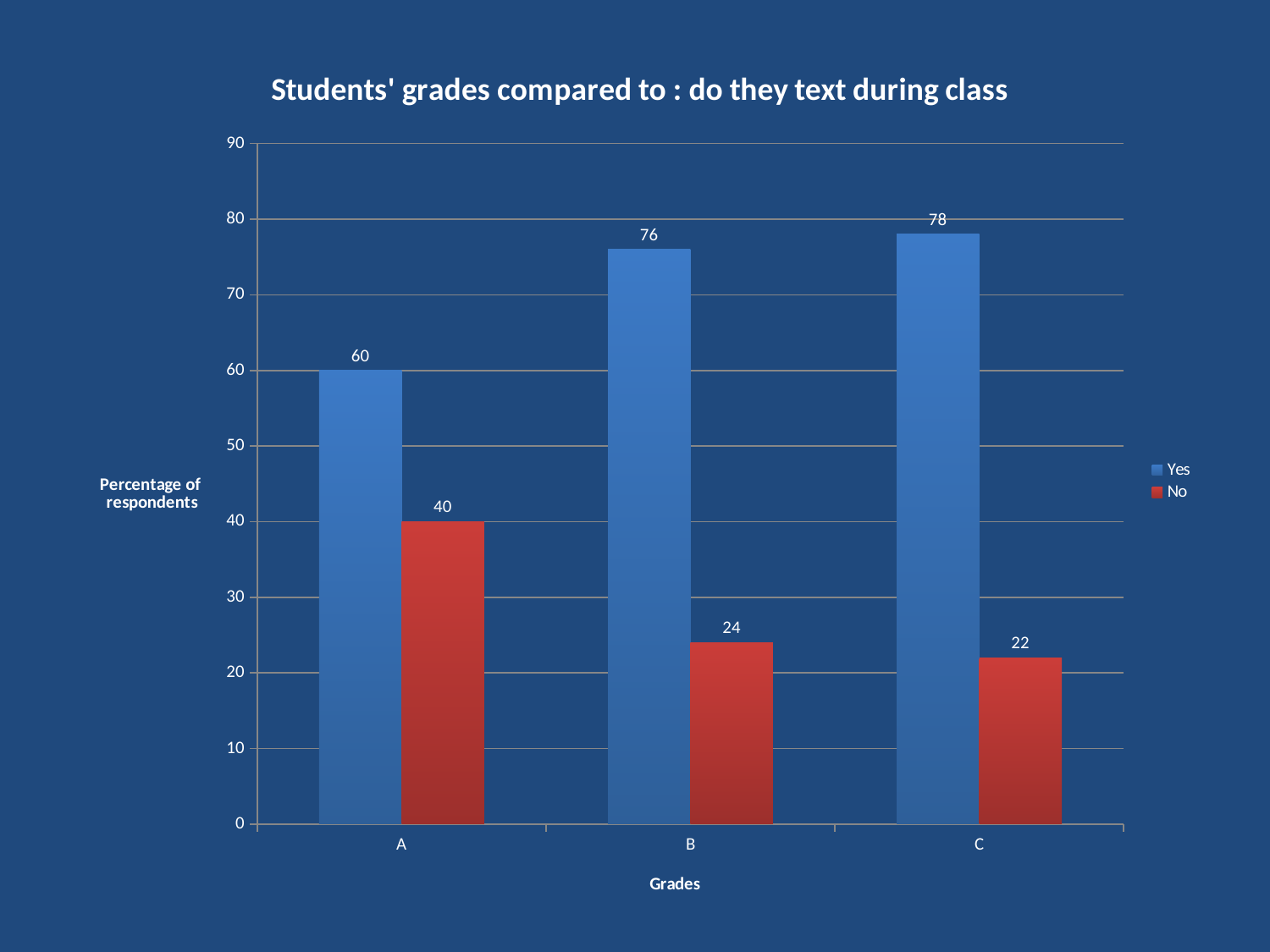
Which grade has the lowest No value? C What is the value for No for grade C? 22 How many series does the legend list? 2 How many grade categories are shown on the x axis? 3 Which is larger, the No value for grade A or the No value for grade B? No for grade A What is the value for Yes for grade A? 60 Do the No values rise or fall from grade A to grade C? Fall Which grade has the highest Yes value? C What is the value for Yes for grade B? 76 What is the difference between the Yes and No values for grade A? 20 What kind of chart is shown on the slide? Bar chart What is the title of the chart? Students' grades compared to : do they text during class